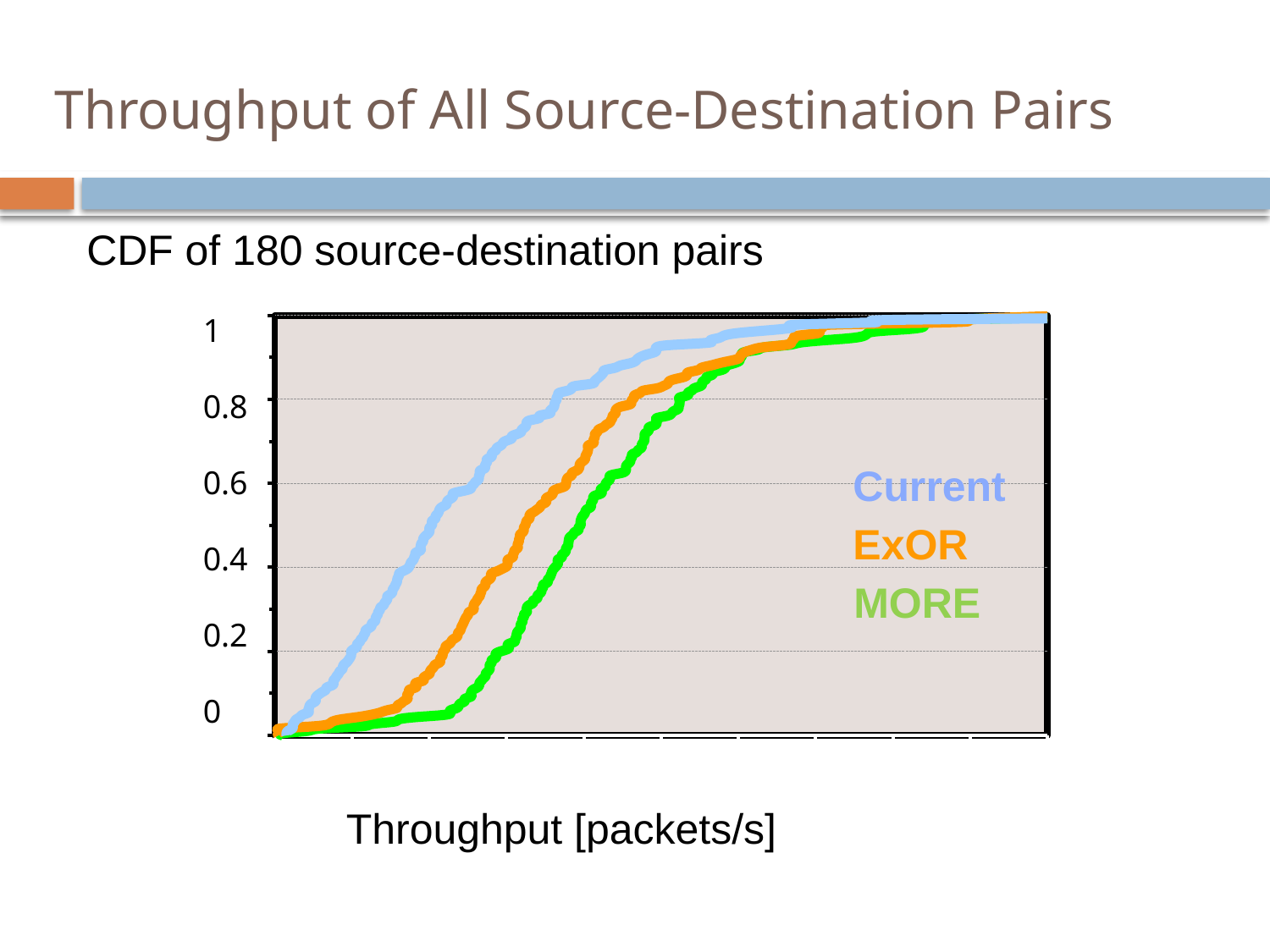
Which series' curve lies furthest to the right, reaching a CDF of 0.4 at the highest throughput? MORE How many labelled tick values are on the y axis? 6 Between Current and ExOR, which series reaches a CDF of 0.8 at a higher throughput? ExOR Which series are listed in the chart's legend? Current, ExOR, MORE How many source-destination pairs does the CDF cover, according to the slide? 180 Between ExOR and MORE, which series reaches a CDF of 0.2 at a lower throughput? ExOR Do the CDF curves rise or fall as throughput increases along the x axis? rise What kind of chart is shown on the slide? line chart How many series are plotted in the chart? 3 What is the highest value labelled on the y axis? 1